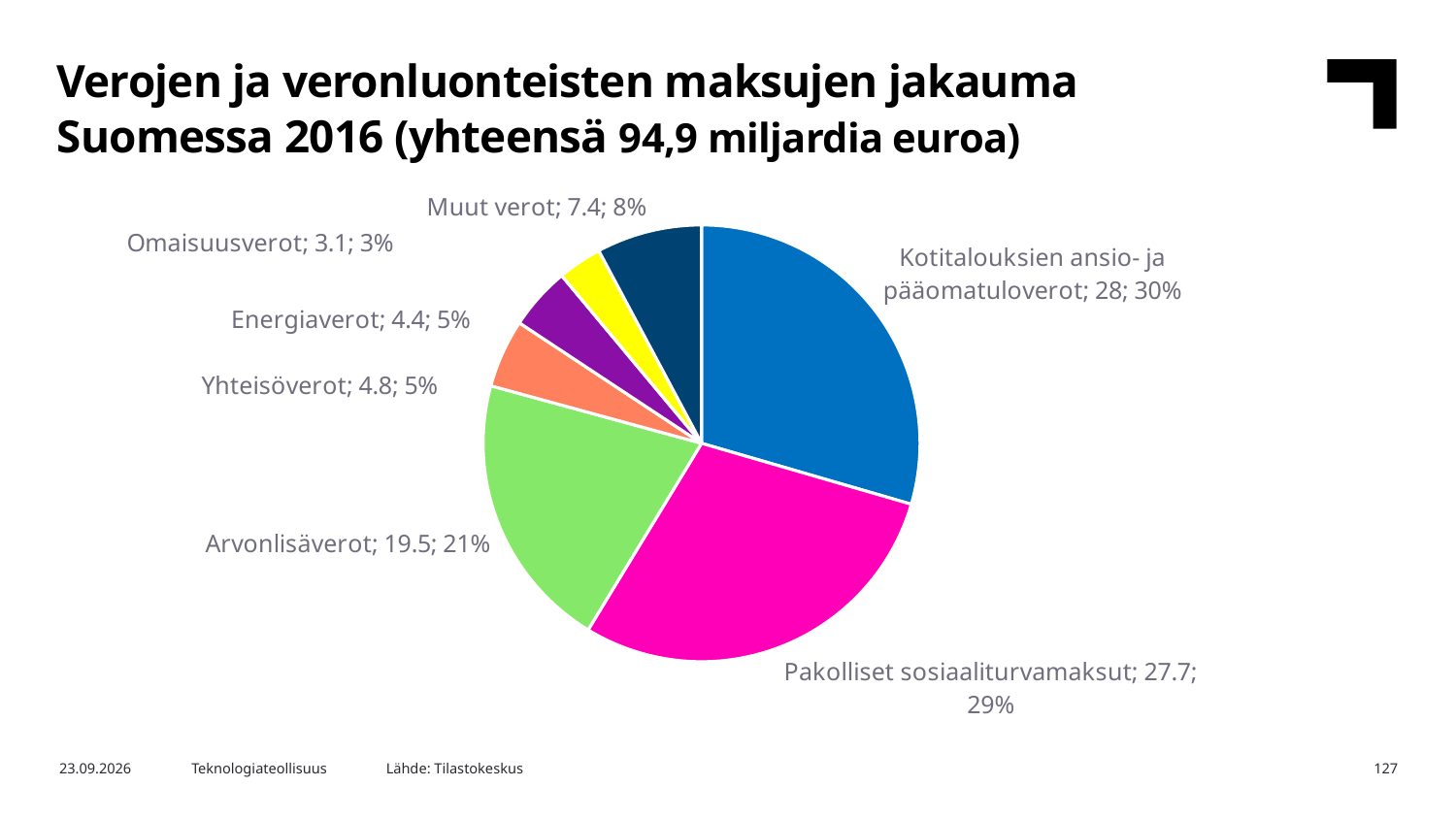
What share of the pie does Pakolliset sosiaaliturvamaksut represent? 29% What is the value shown for Arvonlisäverot? 19.5 What total amount is stated in the chart title? 94,9 miljardia euroa What is the value shown for Muut verot? 7.4 What share of the pie does Omaisuusverot represent? 3% Which is larger, the value for Arvonlisäverot or the value for Muut verot? Arvonlisäverot How many slices does the pie chart have? 7 What is the difference between the values for Kotitalouksien ansio- ja pääomatuloverot and Pakolliset sosiaaliturvamaksut? 0.3 Which category has the largest slice of the pie? Kotitalouksien ansio- ja pääomatuloverot What is the difference between the values for Yhteisöverot and Energiaverot? 0.4 What kind of chart is shown on the slide? Pie chart Which category has the smallest slice of the pie? Omaisuusverot